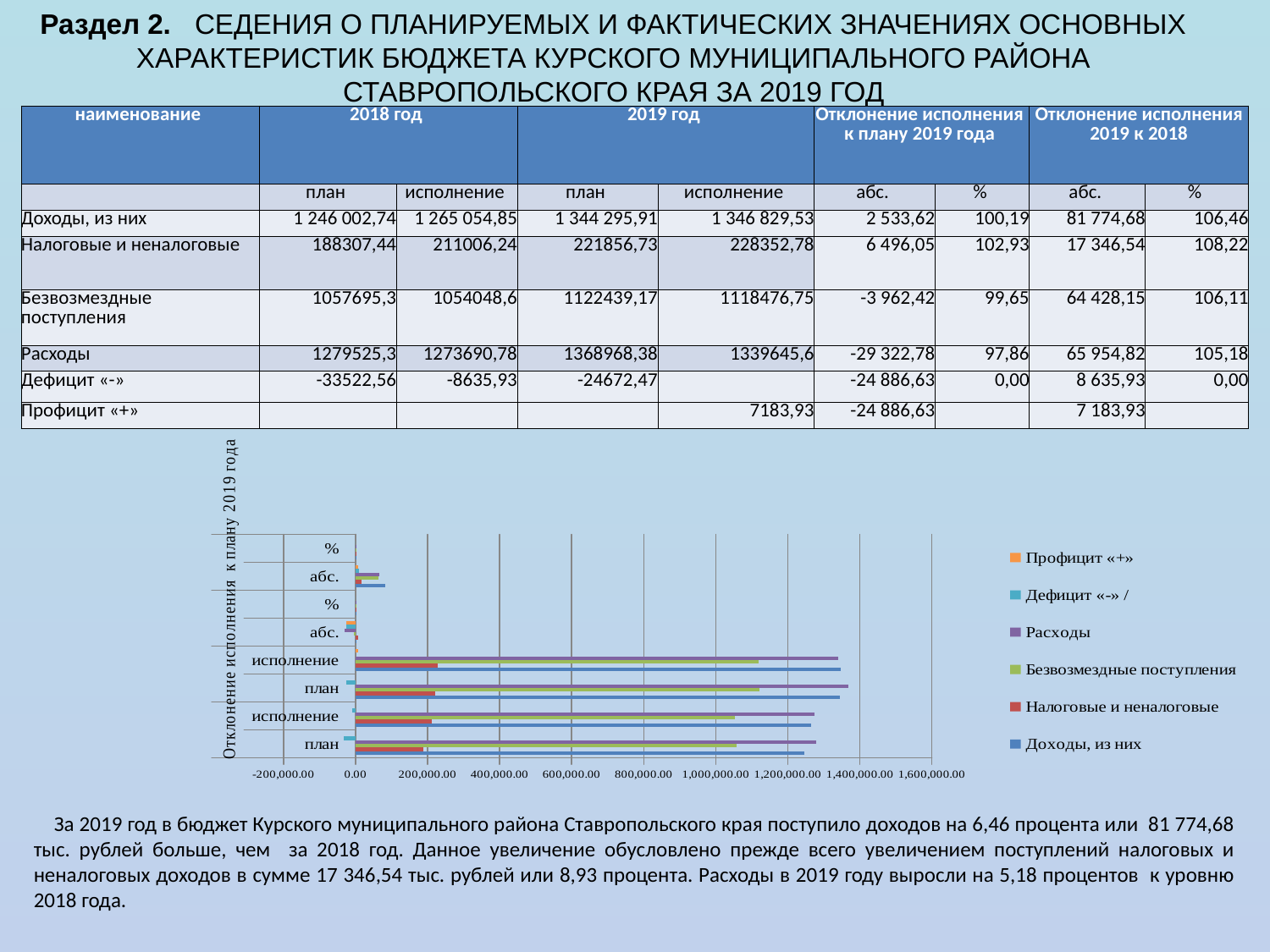
How many categories are shown along the vertical axis of the chart? 8 In the chart, is the value of Безвозмездные поступления for the bottom план category greater or less than 800,000.00? greater In the chart, for the bottom план category, which is larger: Расходы or Налоговые и неналоговые? Расходы How many series does the chart's legend list? 6 In the chart, is the value of Дефицит «-» / for the bottom план category greater or less than 0.00? less In the chart, for the upper исполнение category (third from the bottom), which is larger: Доходы, из них or Безвозмездные поступления? Доходы, из них What kind of chart is shown on the slide? bar chart Which series is listed first in the chart's legend? Профицит «+» In the chart, is the value of Расходы for the bottom план category greater or less than 1,000,000.00? greater What is the title of the chart's vertical axis? Отклонение исполнения к плану 2019 года